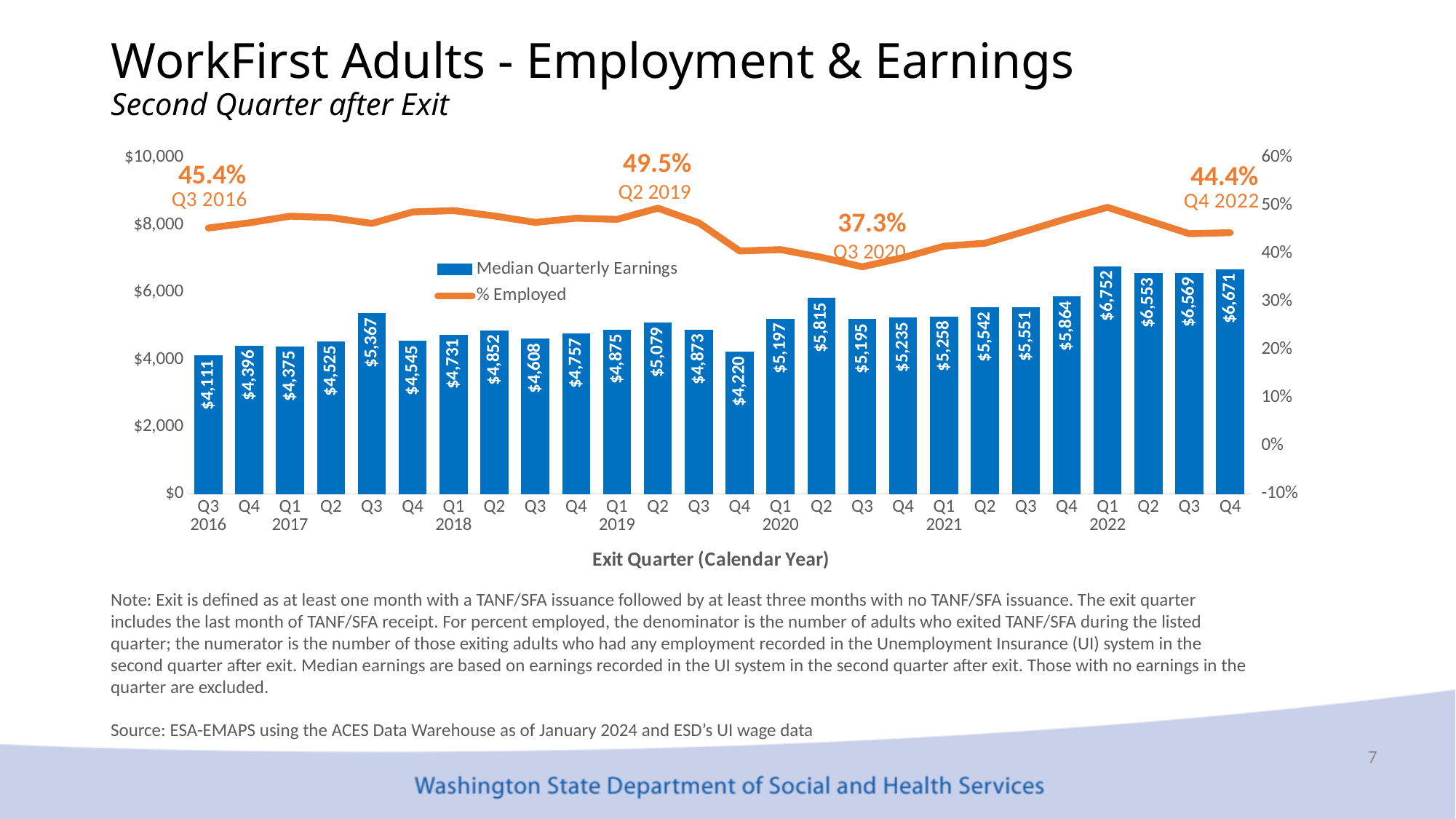
Which exit quarter has the lowest median quarterly earnings? Q3 2016 How many exit quarters are shown on the x axis? 26 Which is larger, the median quarterly earnings for Q2 2022 or Q3 2022? Q3 2022 Which exit quarter has the highest median quarterly earnings? Q1 2022 What colour is the % Employed line? Orange What is the median quarterly earnings value for Q3 2017? $5,367 Is the % Employed value for Q1 2022 greater or less than 40%? greater What is the median quarterly earnings value for Q2 2020? $5,815 What percent employed is labeled for Q3 2020? 37.3% What percent employed is labeled for Q2 2019? 49.5% How many series does the legend list? 2 What is the difference between the median quarterly earnings for Q1 2022 and Q3 2016? $2,641